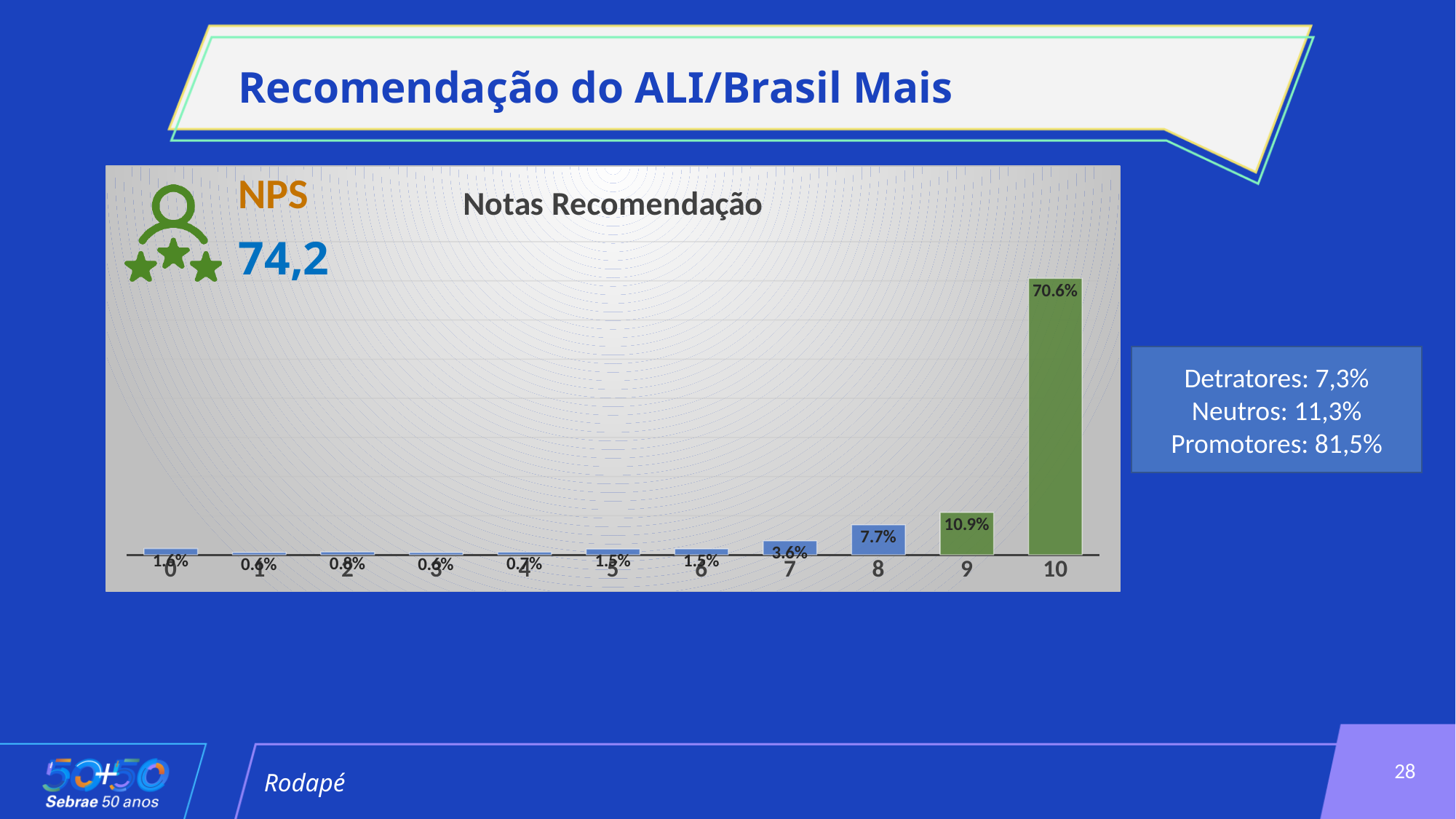
What is the value for score 7 in the Notas Recomendação chart? 3.6% Which has a larger value in the Notas Recomendação chart, score 8 or score 9? Score 9 Which score has the highest value in the Notas Recomendação chart? 10 Do the values rise or fall from score 7 to score 10 in the Notas Recomendação chart? Rise What is the title of the chart on the slide? Notas Recomendação What kind of chart is the Notas Recomendação chart? Bar chart What is the difference between the values for score 10 and score 9 in the Notas Recomendação chart? 59.7 percentage points What is the value for score 8 in the Notas Recomendação chart? 7.7% What is the value for score 10 in the Notas Recomendação chart? 70.6% What is the value for score 9 in the Notas Recomendação chart? 10.9% How many score categories are shown on the x axis of the Notas Recomendação chart? 11 What colour are the bars for scores 9 and 10 in the Notas Recomendação chart? Green